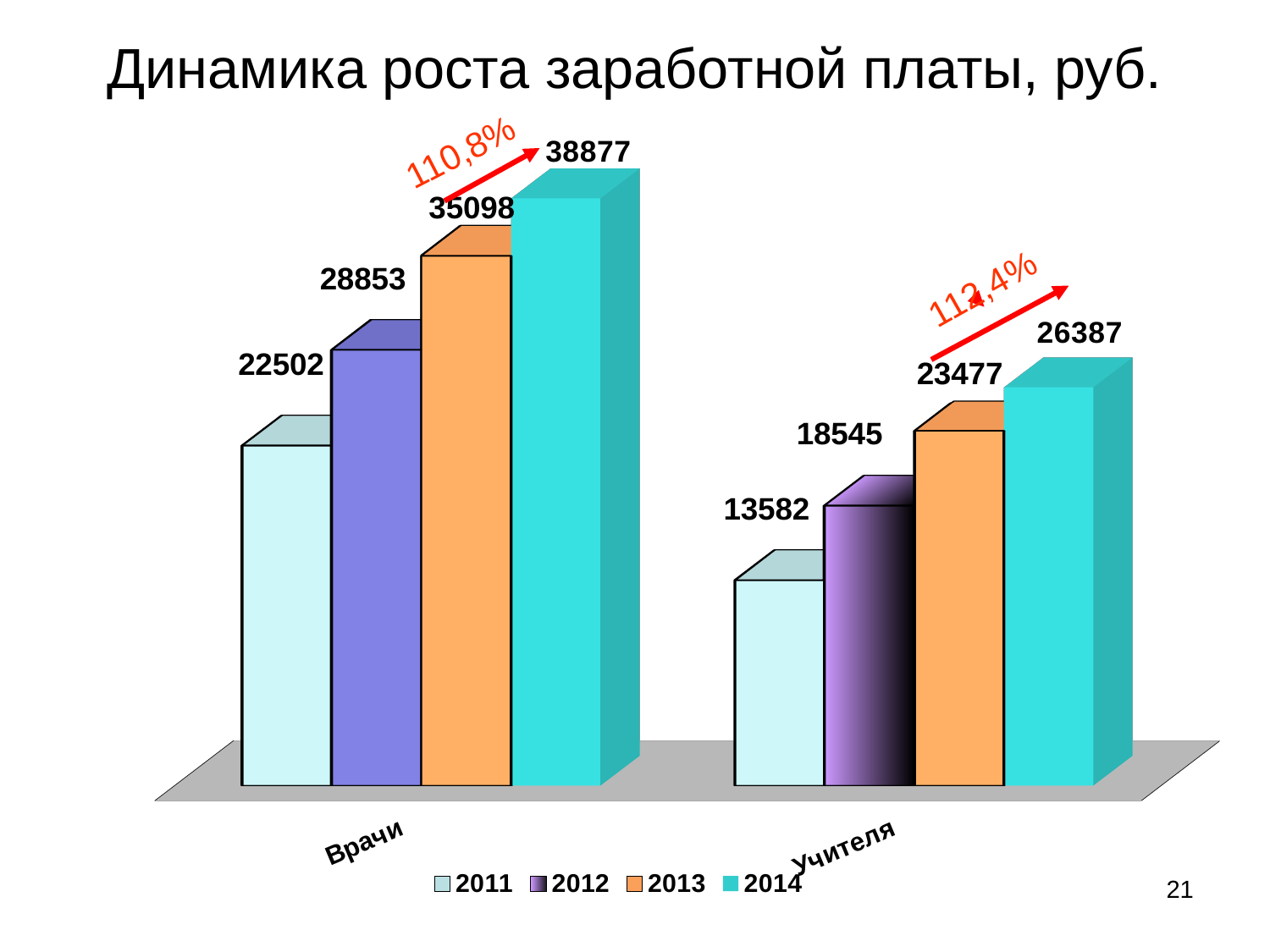
Which year has the lowest value for Врачи? 2011 What kind of chart is shown on the slide? Bar chart How many series does the legend list? 4 What is the value for Врачи in 2014? 38877 What is the value for Врачи in 2012? 28853 What is the difference between the 2014 values for Врачи and Учителя? 12490 Do the values for Врачи rise or fall from 2011 to 2014? Rise What is the value for Учителя in 2013? 23477 What is the value for Учителя in 2011? 13582 Which year has the highest value for Учителя? 2014 Which is larger: the 2013 value for Учителя or the 2011 value for Врачи? 2013 value for Учителя What is the difference between the 2014 and 2013 values for Врачи? 3779